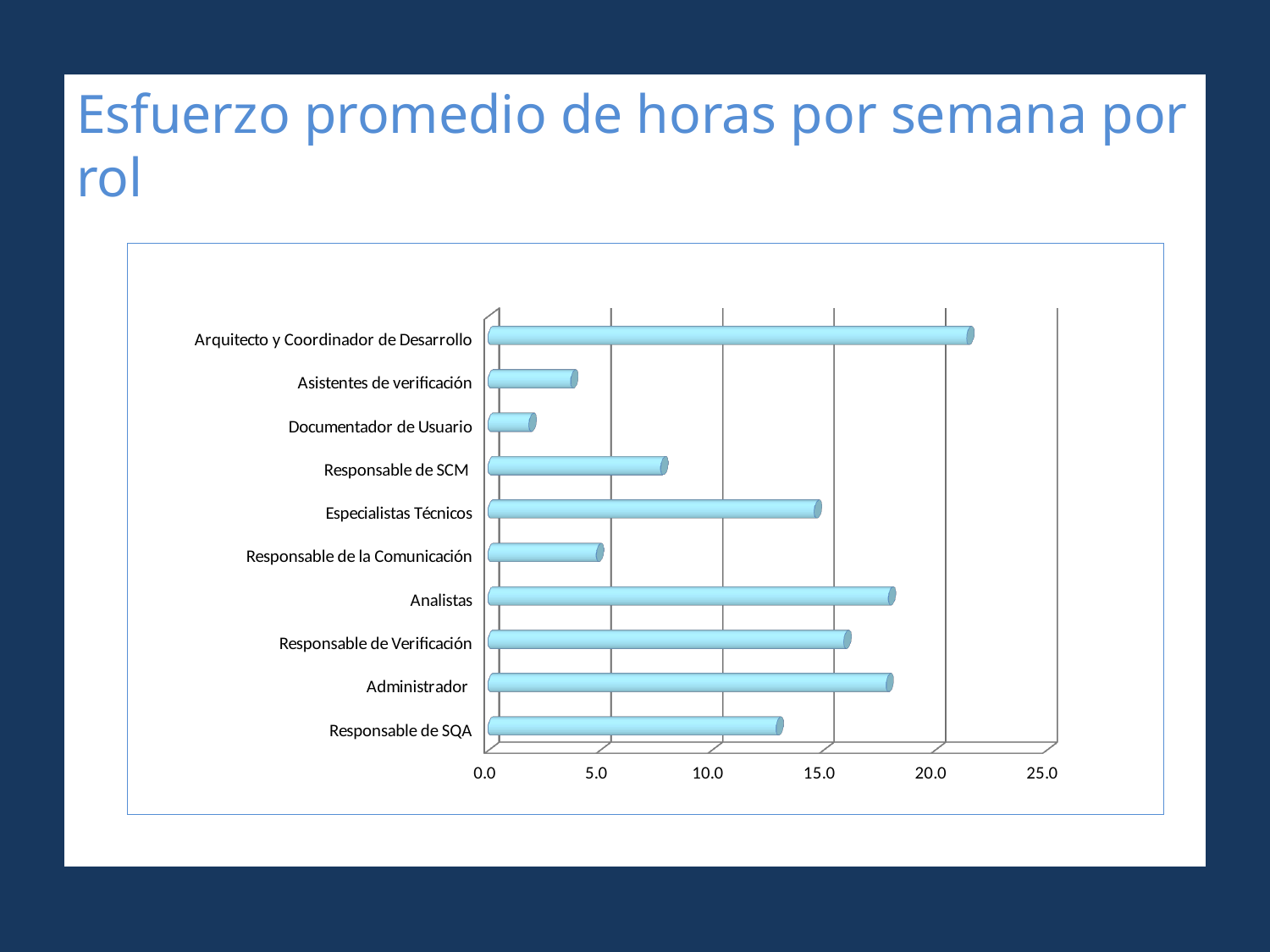
Is the value for Asistentes de verificación greater or less than 5.0? less Is the value for Especialistas Técnicos greater or less than 10.0? greater Is the value for Arquitecto y Coordinador de Desarrollo greater or less than 20.0? greater What is the title of the slide containing the chart? Esfuerzo promedio de horas por semana por rol Which role has the highest average hours per week? Arquitecto y Coordinador de Desarrollo What kind of chart is shown on the slide? bar chart Which is larger, the value for Responsable de Verificación or the value for Responsable de SQA? Responsable de Verificación How many roles (categories) are plotted in the chart? 10 Which is larger, the value for Analistas or the value for Responsable de la Comunicación? Analistas Which role has the lowest average hours per week? Documentador de Usuario